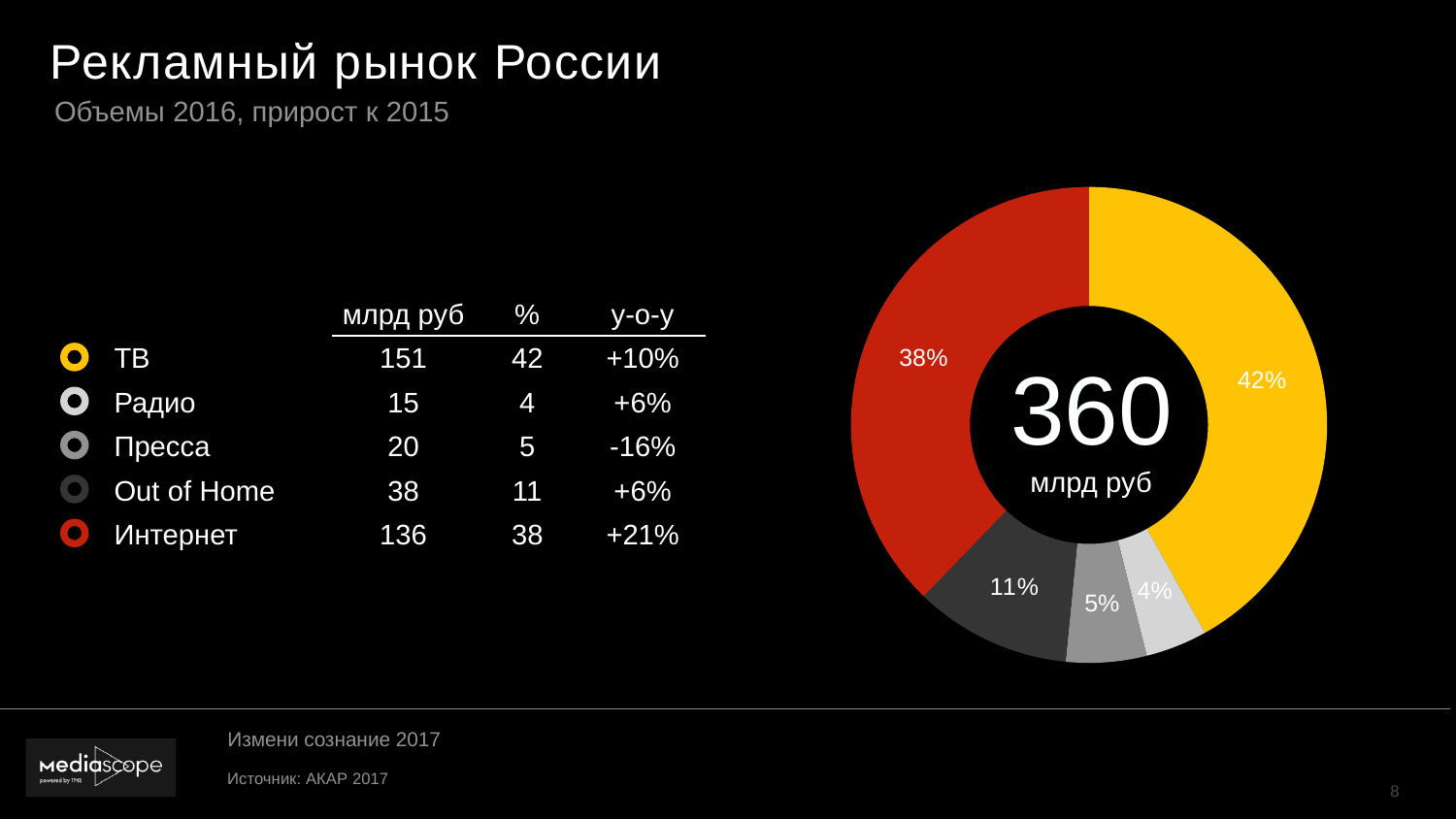
Which category has the largest slice in the pie chart? ТВ What total value is printed in the centre of the donut chart? 360 млрд руб Which slice is larger in the pie chart, Пресса or Out of Home? Out of Home What is the title of the slide containing the pie chart? Рекламный рынок России What kind of chart is shown on the slide? Pie (donut) chart What colour is the Интернет slice in the pie chart? Red What share of the pie chart does Интернет (the red slice) hold? 38% Which category has the smallest slice in the pie chart? Радио By how many percentage points does the ТВ share exceed the Интернет share in the pie chart? 4 How many slices does the pie chart have? 5 What share of the pie chart does Out of Home hold? 11% What share of the pie chart does ТВ (the yellow slice) hold? 42%